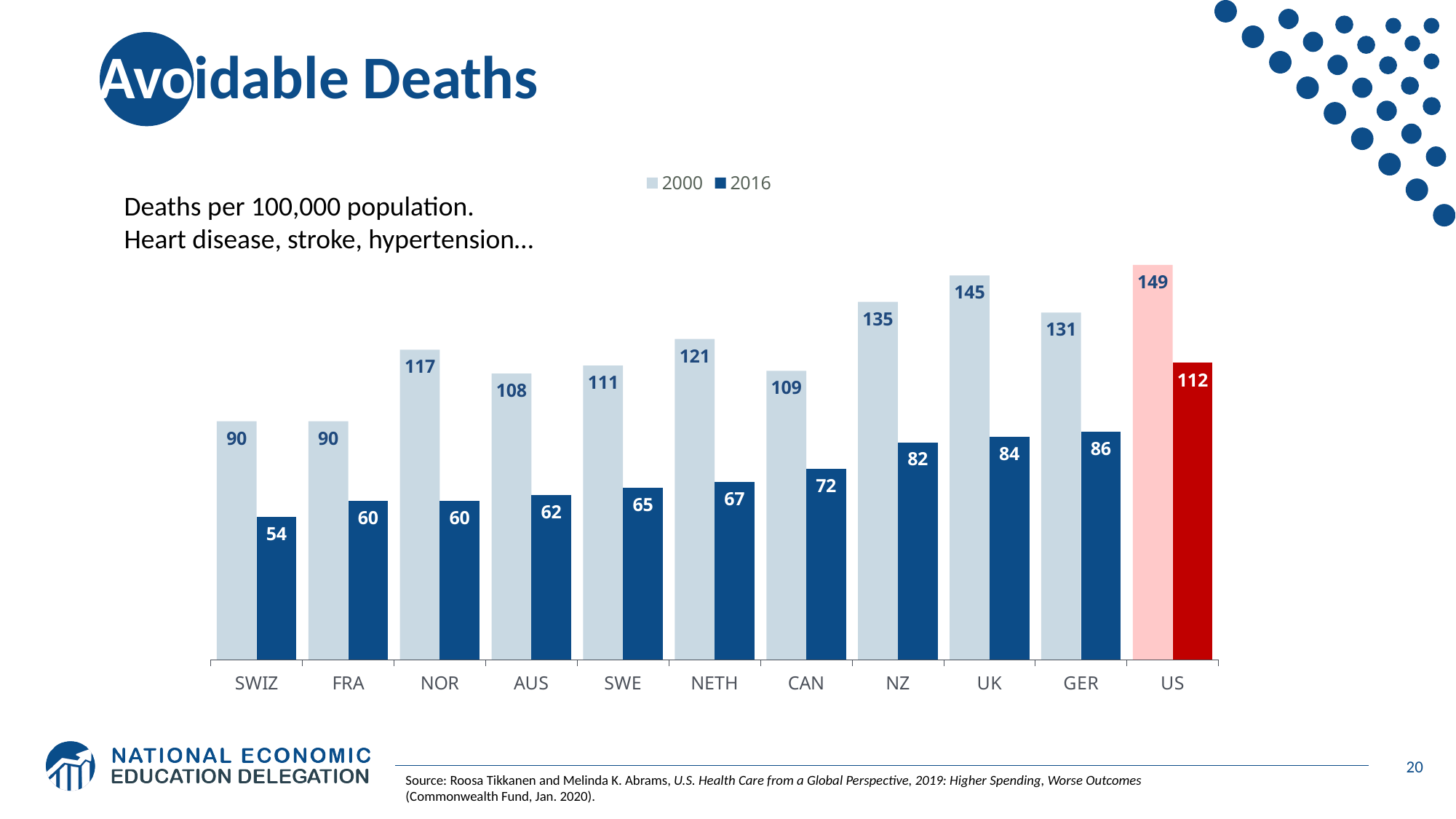
Which country had the highest value in 2016? US What was the value for SWIZ in 2016? 54 What kind of chart is shown on the slide? Bar chart What is the difference between the 2000 and 2016 values for the UK? 61 Which two countries share the same 2000 value of 90? SWIZ and FRA What was the value for NETH in 2000? 121 How many countries are shown on the x axis? 11 Which is larger, the 2016 value for GER or the 2016 value for NZ? GER What was the value for the US in 2000? 149 How many series does the legend list? 2 Which country had the lowest value in 2016? SWIZ Which country's bars are coloured red instead of blue? US